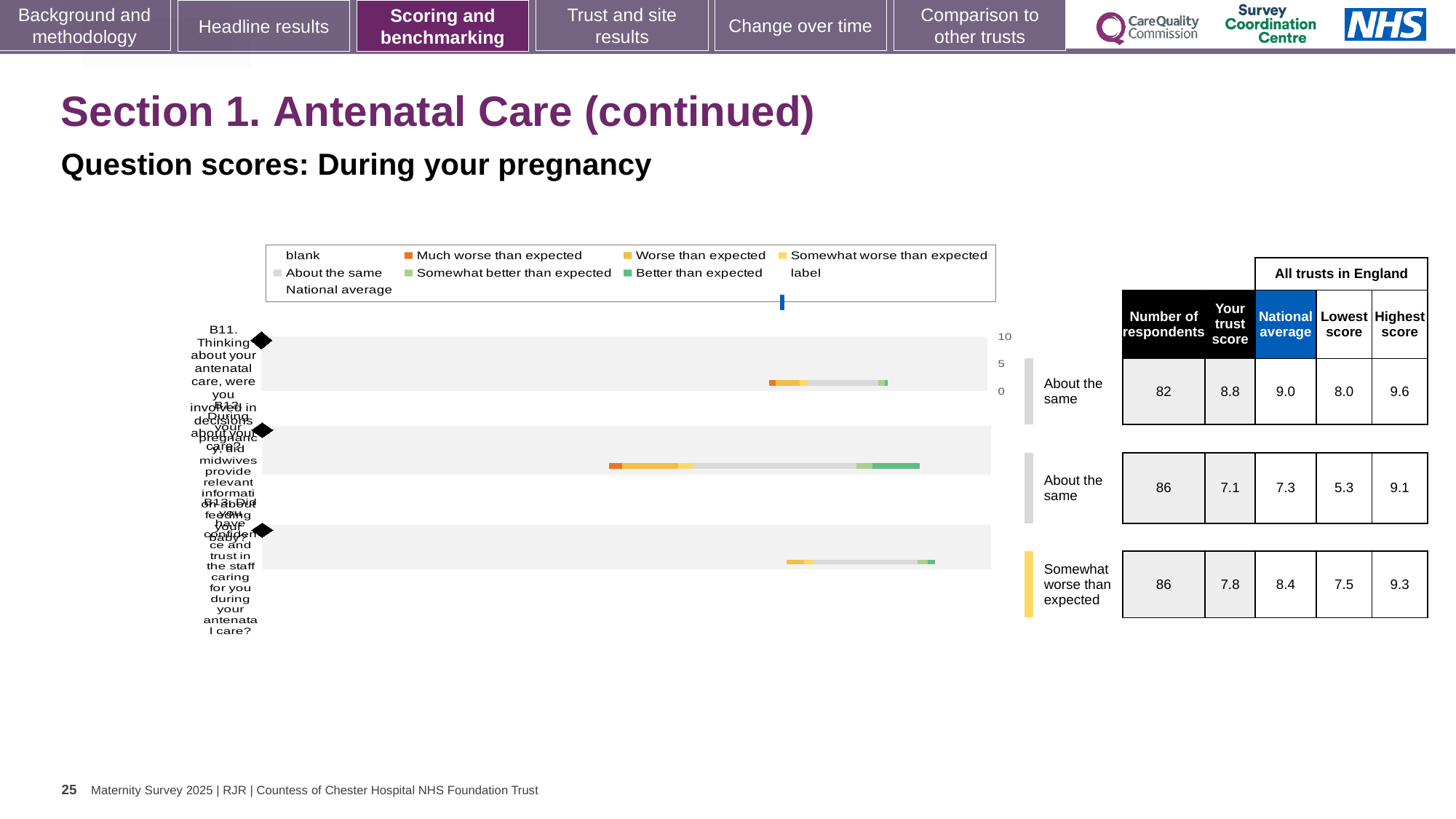
What is the difference between the national average and the trust score for question B13? 0.6 What is the lowest score across all trusts in England for question B13 (confidence and trust in staff during antenatal care)? 7.5 What kind of chart is shown on the slide? bar chart Which is larger, the trust score for B11 or the trust score for B12? B11 How many respondents answered question B11? 82 Which benchmark category is question B13 placed in? Somewhat worse than expected Which of the three questions has the lowest 'Lowest score' across all trusts in England? B12 What is the difference between the highest score and the lowest score for question B12? 3.8 What is the national average for question B12 (midwives provided relevant information about feeding your baby)? 7.3 What is the trust score for question B11 (involved in decisions about antenatal care)? 8.8 How many questions (categories) are plotted in the chart? 3 Which of the three questions has the highest trust score? B11